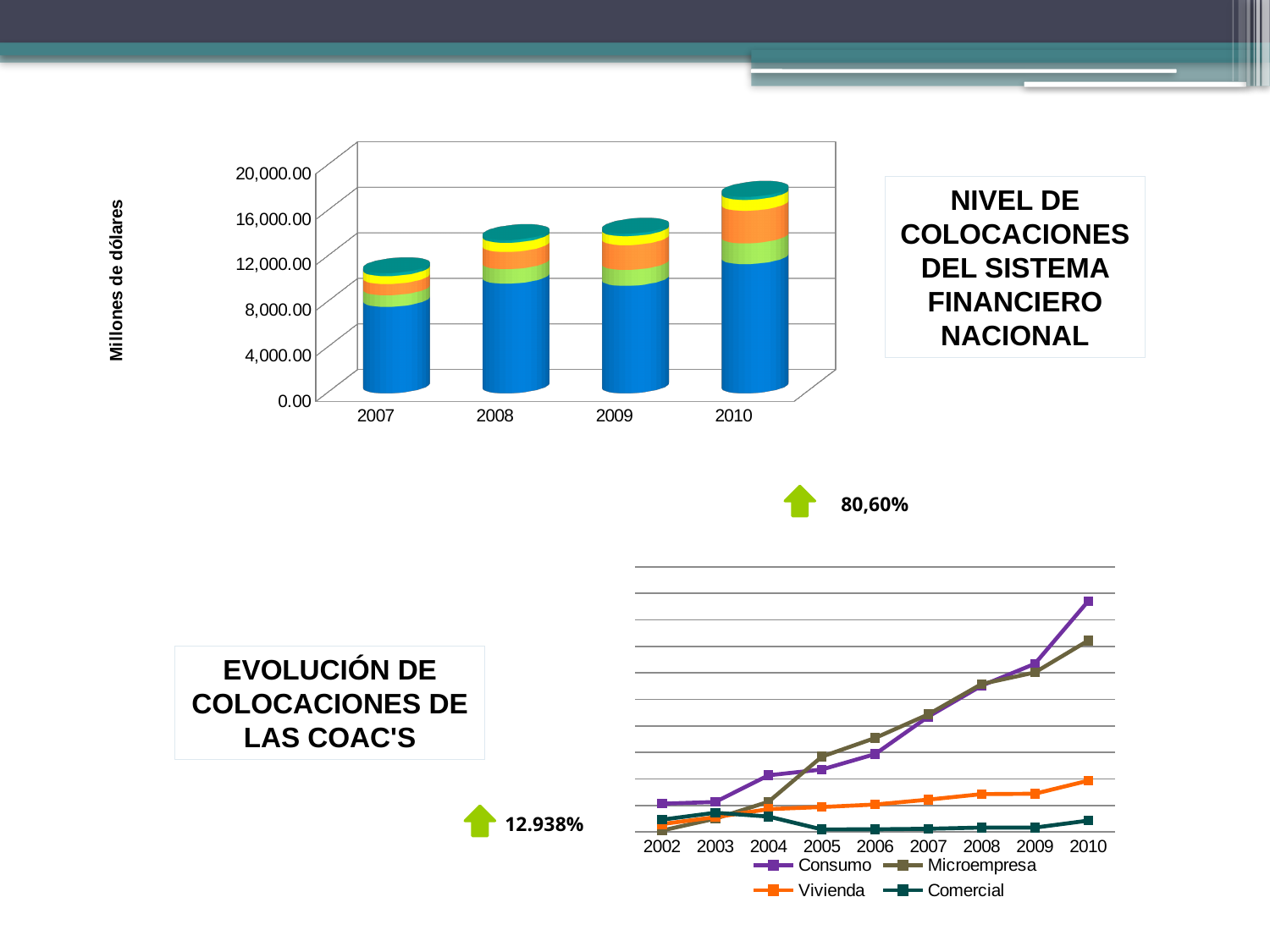
In the top chart (NIVEL DE COLOCACIONES DEL SISTEMA FINANCIERO NACIONAL), which year has the tallest stacked bar? 2010 What kind of chart is the bottom chart titled 'EVOLUCIÓN DE COLOCACIONES DE LAS COAC'S'? Line chart In the bottom chart (EVOLUCIÓN DE COLOCACIONES DE LAS COAC'S), which series has the highest value in 2010? Consumo What kind of chart is the top chart titled 'NIVEL DE COLOCACIONES DEL SISTEMA FINANCIERO NACIONAL'? Bar chart In the top chart (NIVEL DE COLOCACIONES DEL SISTEMA FINANCIERO NACIONAL), is the total for 2010 greater or less than 16,000.00? greater In the top chart (NIVEL DE COLOCACIONES DEL SISTEMA FINANCIERO NACIONAL), is the total for 2007 greater or less than 12,000.00? less How many series does the legend of the bottom chart (EVOLUCIÓN DE COLOCACIONES DE LAS COAC'S) list? 4 In the top chart (NIVEL DE COLOCACIONES DEL SISTEMA FINANCIERO NACIONAL), how many years are shown on the x axis? 4 In the bottom chart (EVOLUCIÓN DE COLOCACIONES DE LAS COAC'S), which series has the lowest value in 2010? Comercial What is the y-axis label of the top chart (NIVEL DE COLOCACIONES DEL SISTEMA FINANCIERO NACIONAL)? Millones de dólares In the top chart (NIVEL DE COLOCACIONES DEL SISTEMA FINANCIERO NACIONAL), which year has the shortest stacked bar? 2007 In the top chart (NIVEL DE COLOCACIONES DEL SISTEMA FINANCIERO NACIONAL), do the bar totals rise or fall from 2007 to 2010? Rise